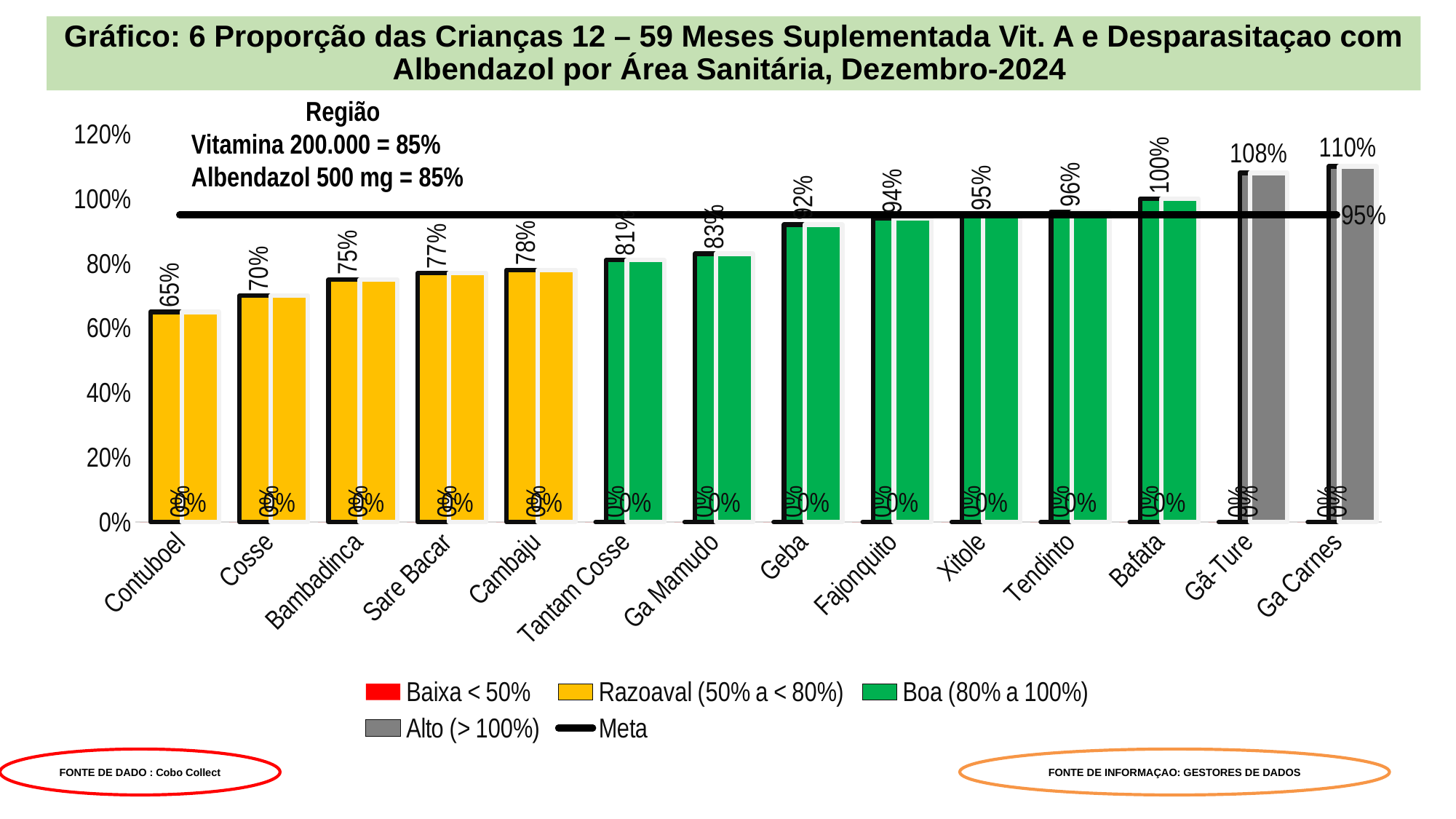
What is the difference between the values for Ga Carnes and Gã-Ture? 2% Which area has the highest value? Ga Carnes Which is larger, the value for Tendinto or the value for Tantam Cosse? Tendinto What is the value shown for Bafata? 100% What is the value shown for Contuboel? 65% How many entries does the legend list? 5 What is the value shown for Geba? 92% How many areas are shown on the x axis? 14 Which area has the lowest value? Contuboel What kind of chart is this? bar chart What is the difference between the values for Cambaju and Cosse? 8% What value does the Meta line mark? 95%